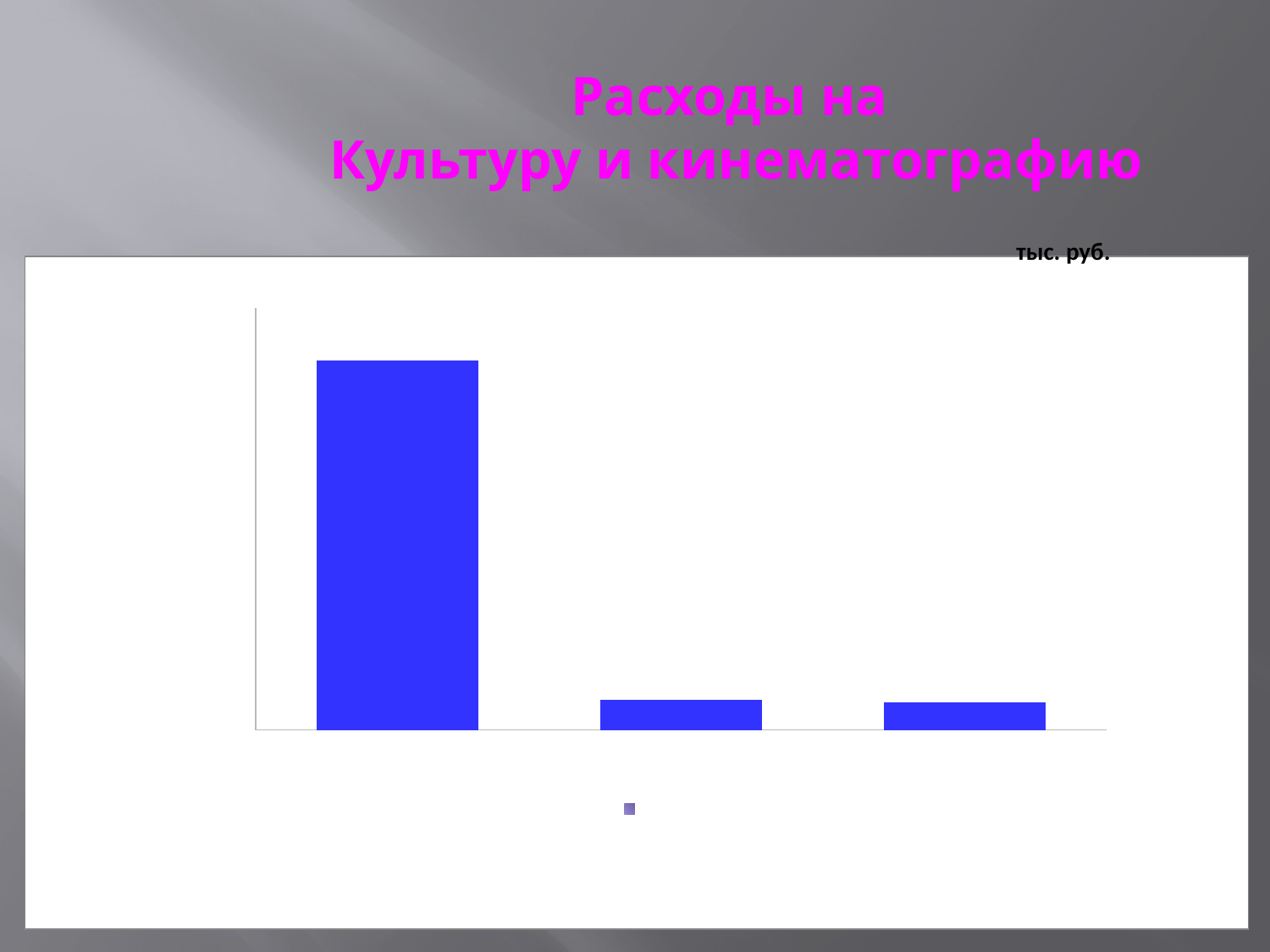
Do the bar values rise or fall from the leftmost bar to the middle bar? fall What is the title of the slide containing the chart? Расходы на Культуру и кинематографию Which is larger, the leftmost bar or the rightmost bar? the leftmost bar Which bar is the tallest in the chart: the leftmost, the middle, or the rightmost? the leftmost How many entries does the chart legend show? 1 What unit is indicated above the chart? тыс. руб. Which is larger, the leftmost bar or the middle bar? the leftmost bar How many bars are plotted in the chart? 3 What kind of chart is shown on the slide? bar chart